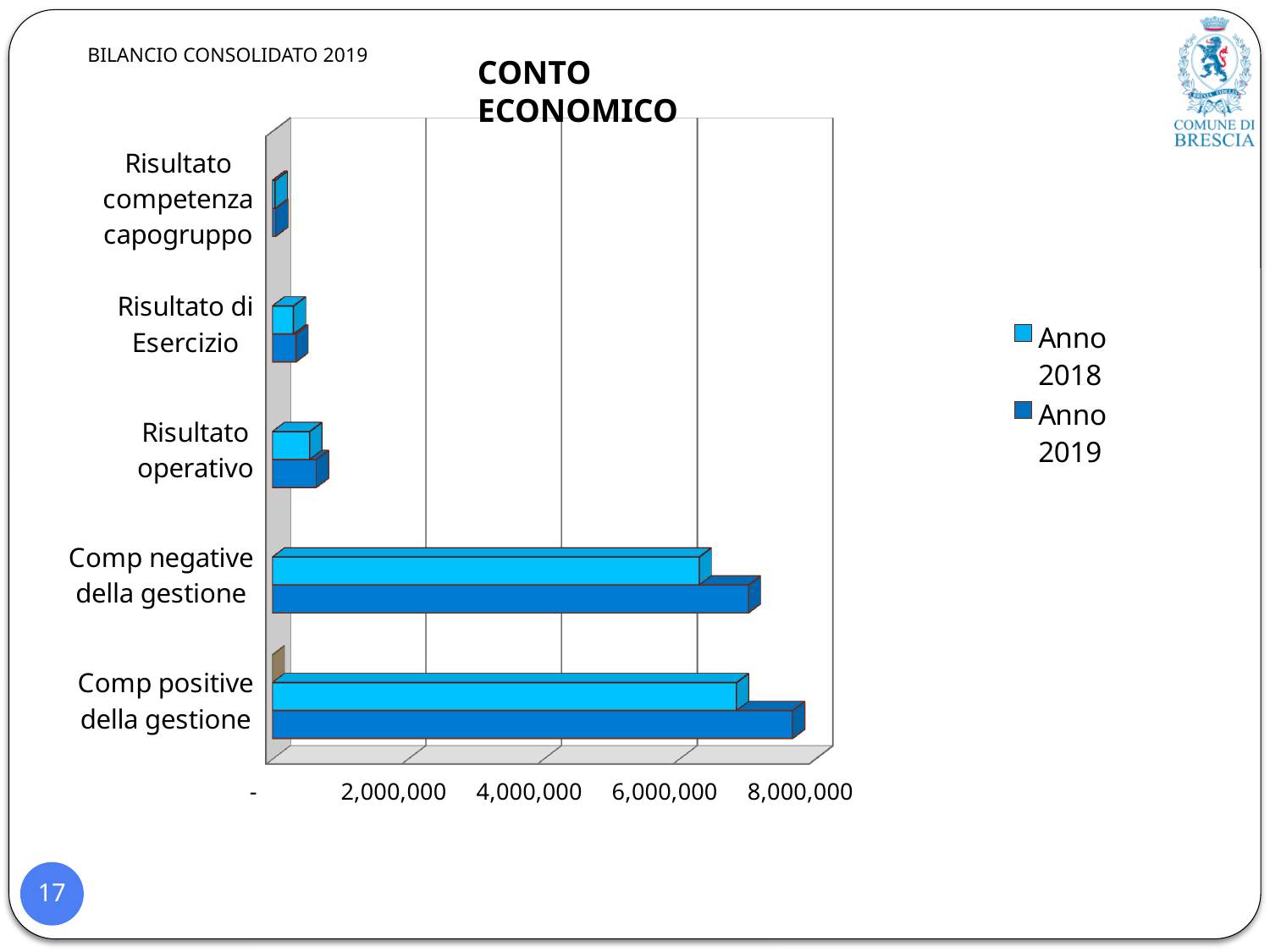
For Comp positive della gestione, which year has the larger value, Anno 2018 or Anno 2019? Anno 2019 Which category has the lowest value for Anno 2018? Risultato competenza capogruppo Is the Anno 2019 value for Comp positive della gestione greater or less than 6,000,000? greater Which category has the highest value for Anno 2019? Comp positive della gestione Is the Anno 2018 value for Comp negative della gestione greater or less than 4,000,000? greater Is the Anno 2019 value for Risultato operativo greater or less than 2,000,000? less How many series does the legend list? 2 What is the title of the chart? CONTO ECONOMICO How many categories are shown on the chart? 5 What kind of chart is shown on the slide? bar chart For Comp negative della gestione, which year has the larger value, Anno 2018 or Anno 2019? Anno 2019